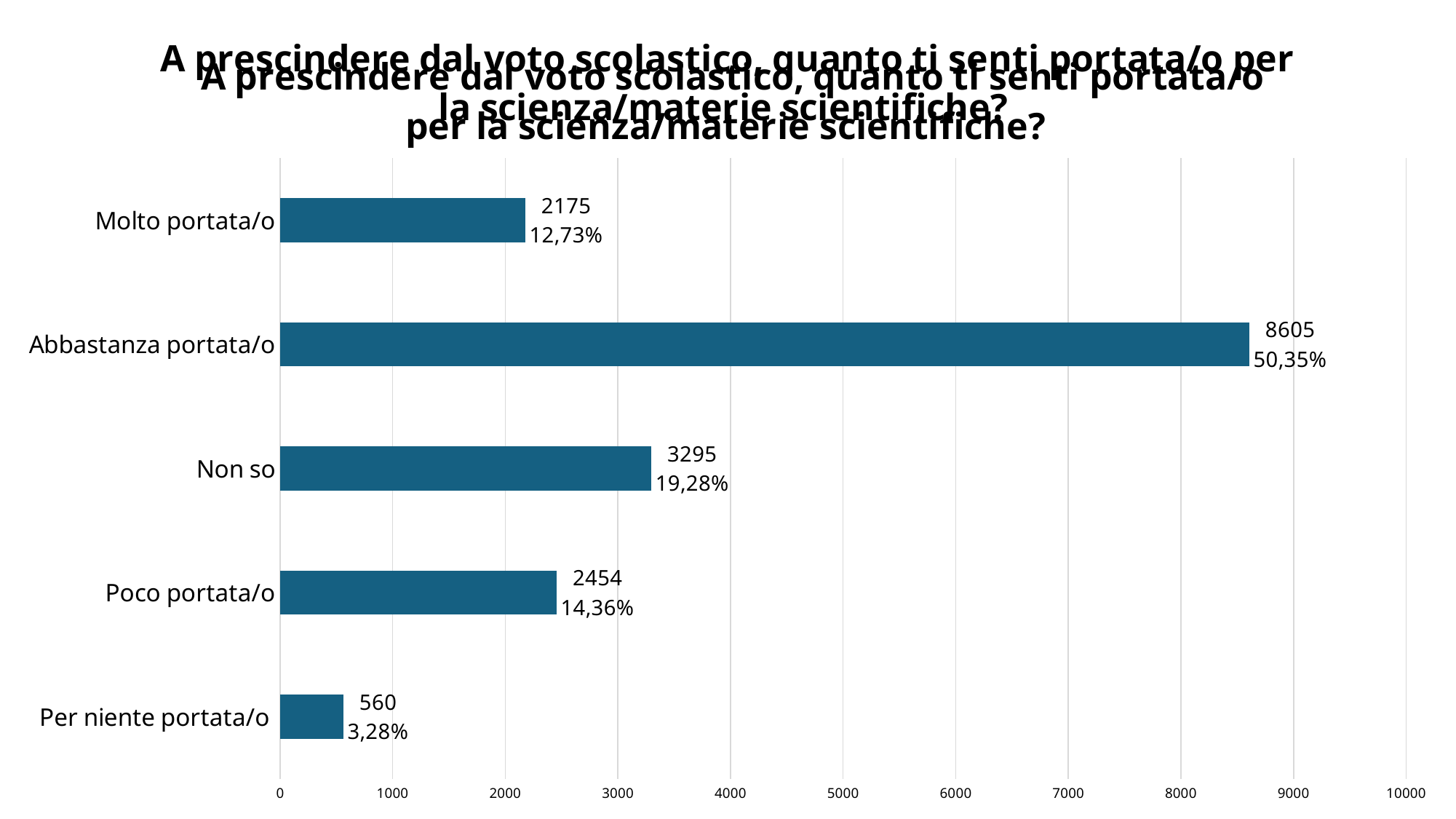
What type of chart is shown on the slide? bar chart What is the value for "Per niente portata/o"? 560 What is the maximum value shown on the horizontal axis? 10000 Is the value for "Abbastanza portata/o" greater or less than 8000? greater What is the difference between the values for "Poco portata/o" and "Molto portata/o"? 279 What percentage is shown for "Non so"? 19,28% Which category has the highest value? Abbastanza portata/o What percentage is shown for "Molto portata/o"? 12,73% How many categories are shown in the chart? 5 Which category has the lowest value? Per niente portata/o Which is larger, the value for "Non so" or the value for "Poco portata/o"? Non so What is the value for "Abbastanza portata/o"? 8605